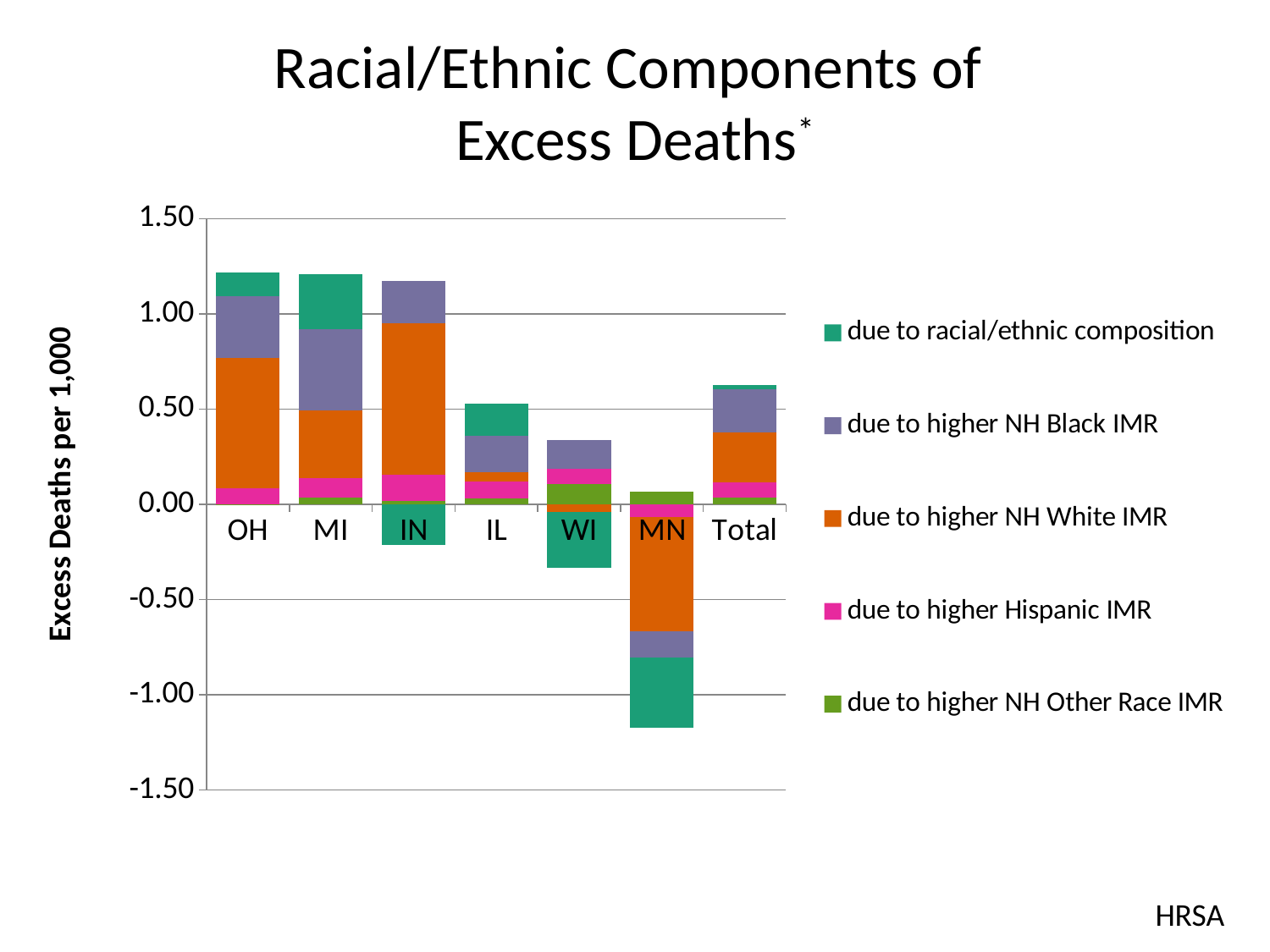
Which legend entry is shown in orange? due to higher NH White IMR Which has the larger 'due to higher NH White IMR' segment, IN or MI? IN Is the top of the positive stacked bar for WI greater or less than 0.50? less How many categories are shown along the x axis of the chart? 7 Which has the taller positive stacked bar, OH or WI? OH Which category has the lowest (most negative) stacked bar in the chart? MN What is the label on the vertical axis of the chart? Excess Deaths per 1,000 What kind of chart is shown on the slide? Stacked bar chart How many series does the chart's legend list? 5 Is the 'due to higher NH White IMR' segment for IN greater or less than 0.50? greater Is the bottom of the negative stacked bar for MN greater or less than -1.00? less